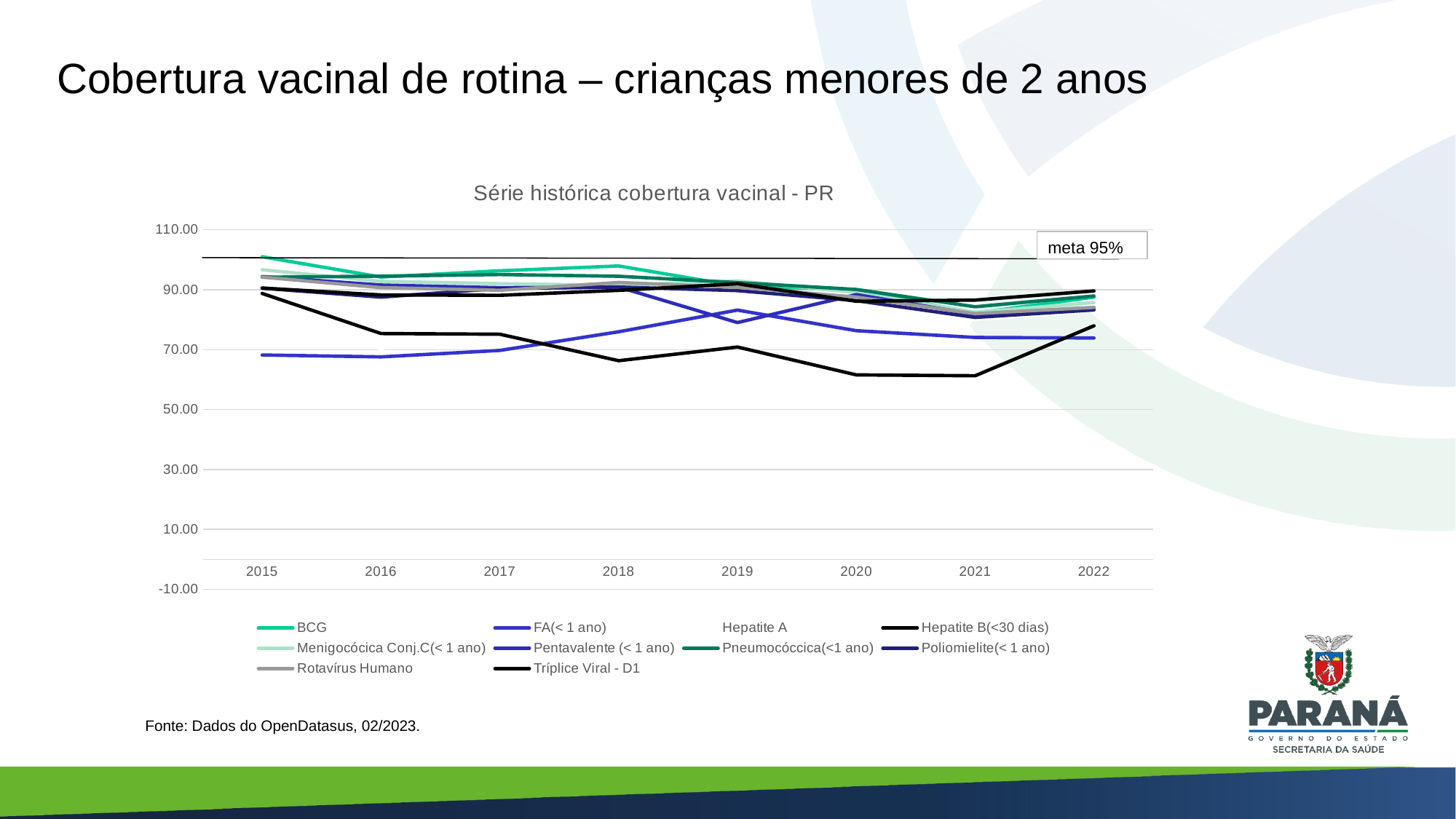
How many series does the legend list? 10 Is the lowest plotted value in 2021 greater or less than 70? less Is the value for BCG in 2015 greater or less than 90? greater What is the last year shown on the x axis? 2022 What is the title of the chart? Série histórica cobertura vacinal - PR How many years are shown along the x axis? 8 What is the first year shown on the x axis? 2015 Is the value for BCG in 2018 greater or less than 90? greater What target value is labelled on the horizontal reference line in the chart? meta 95% What kind of chart is shown on the slide? line chart What is the highest value shown on the y axis? 110.00